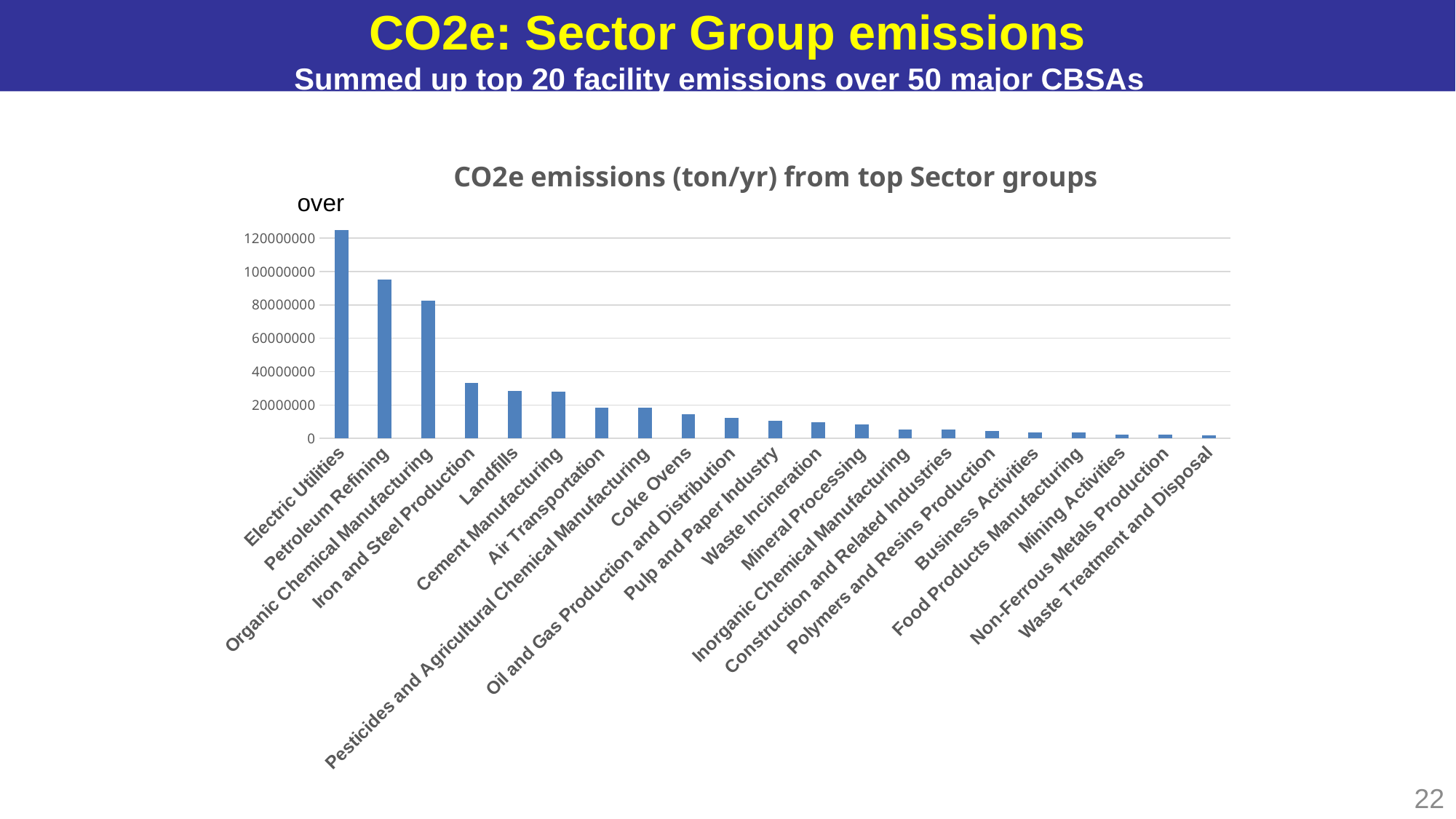
Is the value for Petroleum Refining greater or less than 100000000? less Which sector group has the highest CO2e emissions? Electric Utilities Is the value for Electric Utilities greater or less than 120000000? greater Is the value for Organic Chemical Manufacturing greater or less than 80000000? greater Which has higher CO2e emissions, Petroleum Refining or Organic Chemical Manufacturing? Petroleum Refining What kind of chart is shown on the slide? bar chart What is the title of the chart? CO2e emissions (ton/yr) from top Sector groups Do the values rise or fall moving from left to right along the x axis? fall Which has higher CO2e emissions, Coke Ovens or Landfills? Landfills How many sector groups are plotted in the chart? 21 Which sector group has the lowest CO2e emissions? Waste Treatment and Disposal